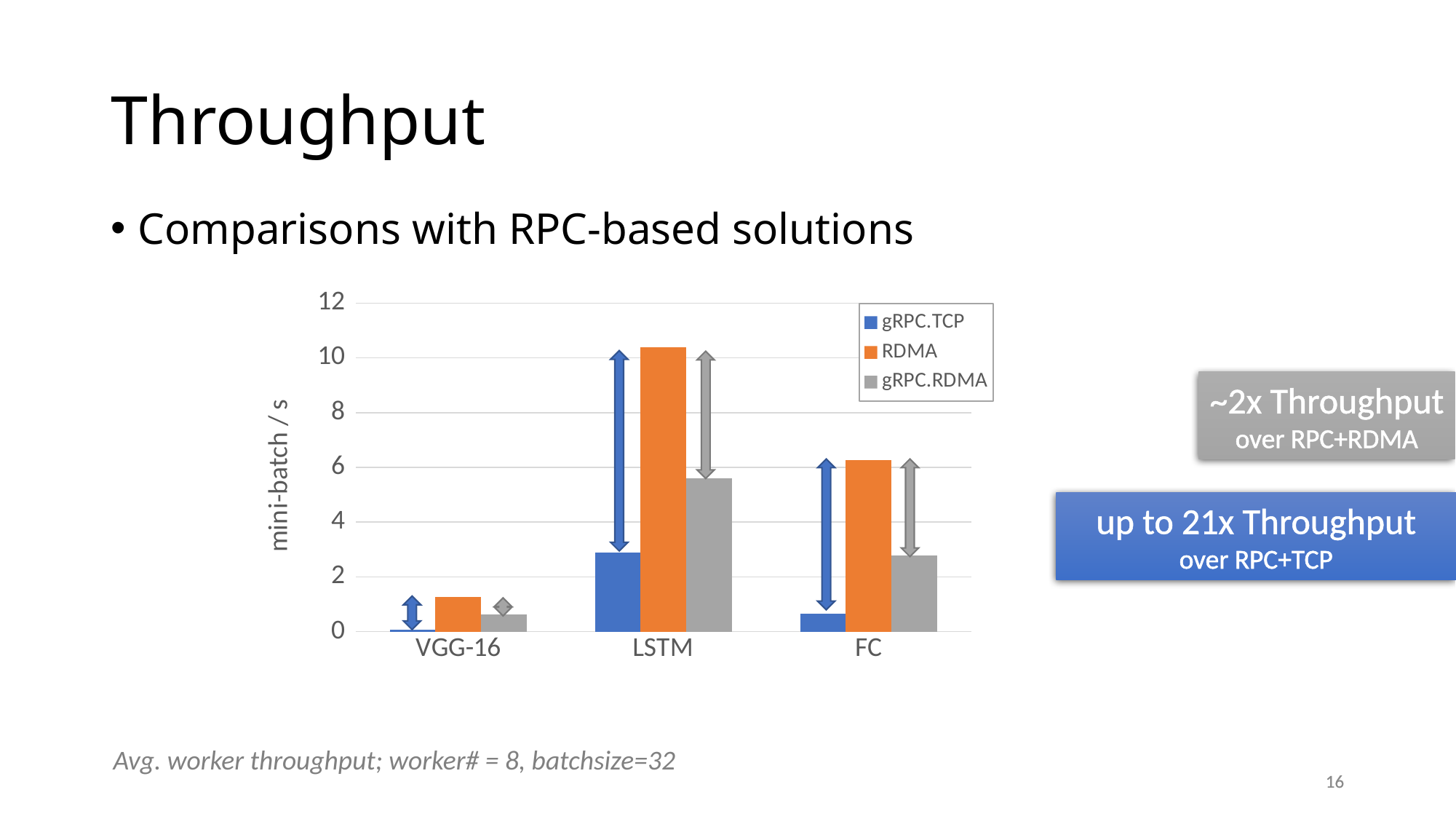
For FC, which series has the larger value: gRPC.TCP or gRPC.RDMA? gRPC.RDMA Which category has the lowest gRPC.TCP throughput? VGG-16 What type of chart is shown on the slide? bar chart How many series does the legend list? 3 How many categories are shown on the x axis? 3 Which category has the highest RDMA throughput? LSTM Is the RDMA value for VGG-16 greater or less than 2? less Is the gRPC.TCP value for LSTM greater or less than 4? less What is the label of the y axis? mini-batch / s Is the RDMA value for FC greater or less than 4? greater For LSTM, which series has the larger value: RDMA or gRPC.RDMA? RDMA